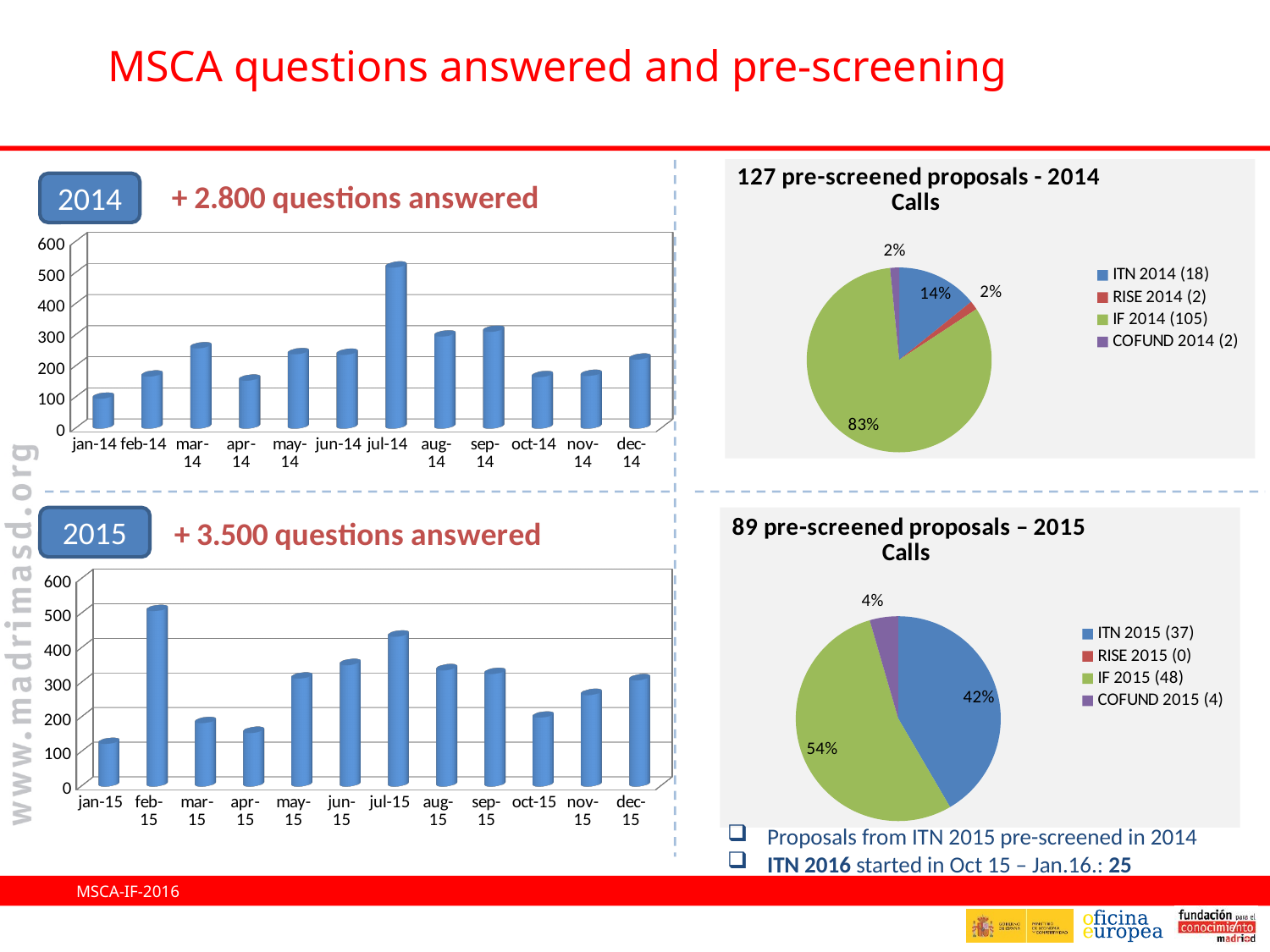
How many months are shown on the x axis of the 2015 questions answered bar chart? 12 In the '89 pre-screened proposals – 2015 Calls' pie chart, what share does ITN 2015 have? 42% How many entries does the legend of the '89 pre-screened proposals – 2015 Calls' pie chart list? 4 In the 2014 questions answered bar chart, is the value for jul-14 greater or less than 500? greater In the 2015 questions answered bar chart, which month has the highest value? feb-15 In the '127 pre-screened proposals - 2014 Calls' pie chart, what share does IF 2014 have? 83% In the 2015 questions answered bar chart, which is larger, the value for jun-15 or jul-15? jul-15 In the 2014 questions answered bar chart, which month has the highest value? jul-14 In the 2015 questions answered bar chart, is the value for jan-15 greater or less than 200? less What kind of chart is used for the 2014 questions answered data? bar chart In the '127 pre-screened proposals - 2014 Calls' pie chart, how many proposals does the legend give for ITN 2014? 18 In the 2014 questions answered bar chart, which month has the lowest value? jan-14